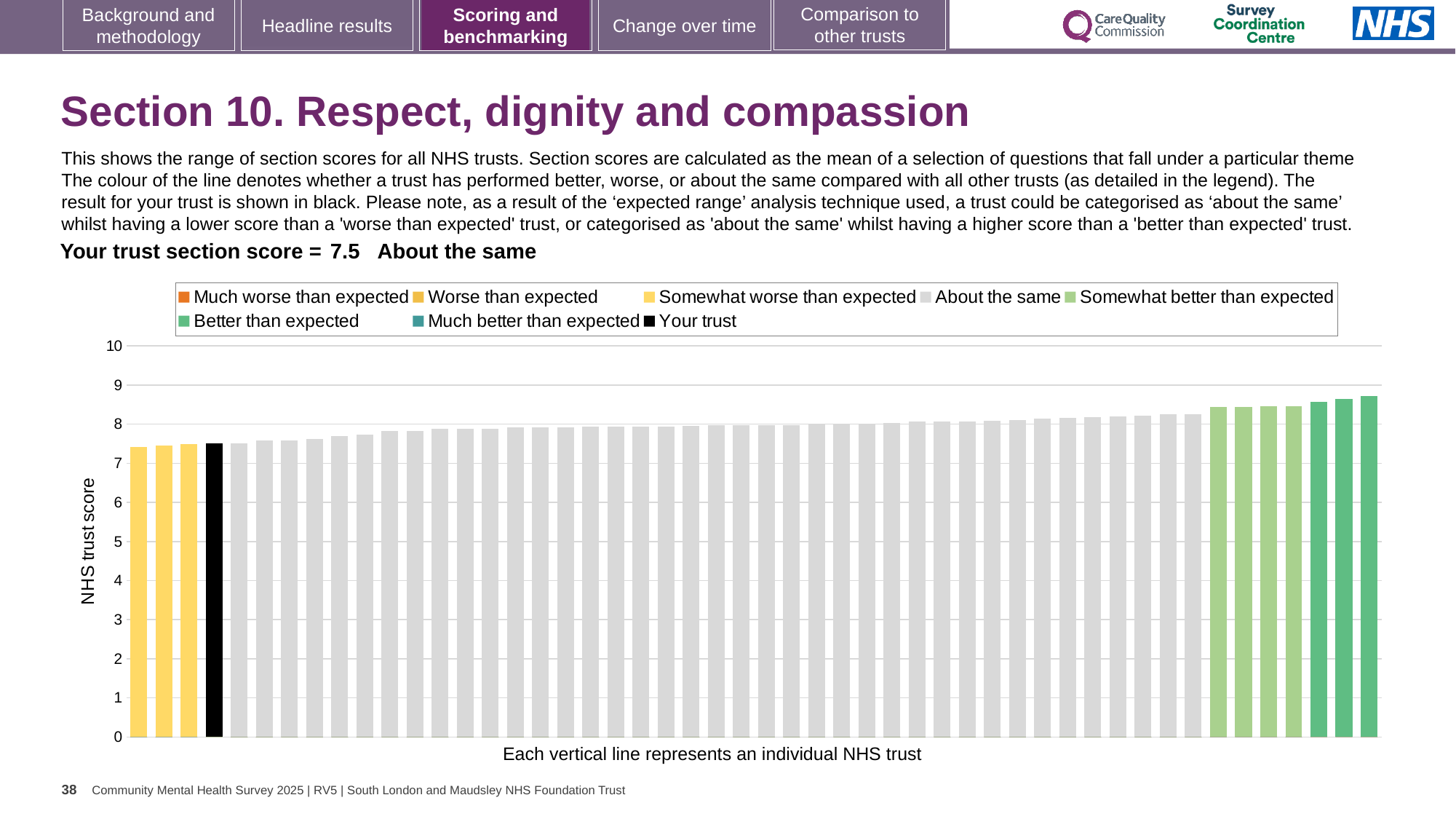
Is the value for your trust greater or less than 8? less What colour is used for 'Your trust' in the legend? black How many bars are coloured 'Somewhat worse than expected' (yellow)? 3 What is the label on the y axis? NHS trust score How many entries does the legend list? 8 Is the value of the rightmost (highest) bar greater or less than 8? greater Is the value for your trust greater or less than 7? greater What is the section score for your trust? 7.5 Do the bar values rise or fall from left to right along the x axis? rise What kind of chart is shown on the slide? bar chart Which is larger, the rightmost bar or the leftmost bar? the rightmost bar